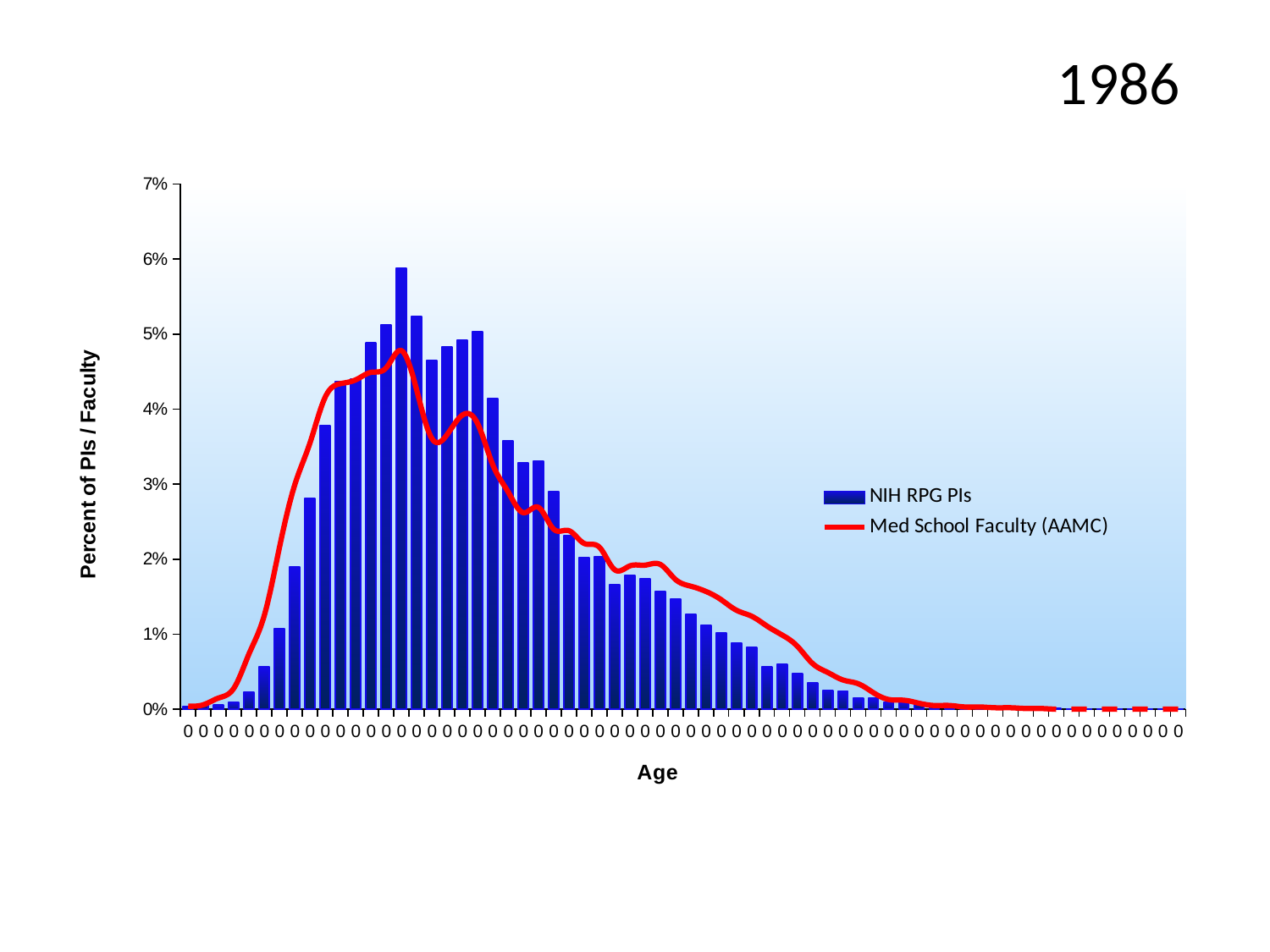
What are the two series named in the legend? NIH RPG PIs and Med School Faculty (AAMC) What is the title of the vertical axis? Percent of PIs / Faculty Is the value of the tallest NIH RPG PIs bar greater or less than 6%? less Which reaches a higher peak value: the NIH RPG PIs bars or the Med School Faculty (AAMC) line? NIH RPG PIs bars After their peak, do the NIH RPG PIs values rise or fall as age increases along the x axis? fall Is the value of the Med School Faculty (AAMC) line at the far right of the x axis greater or less than 1%? less What kind of chart is shown on the slide? Bar chart with a line series Is the highest point of the Med School Faculty (AAMC) line greater or less than 5%? less How many series does the legend list? 2